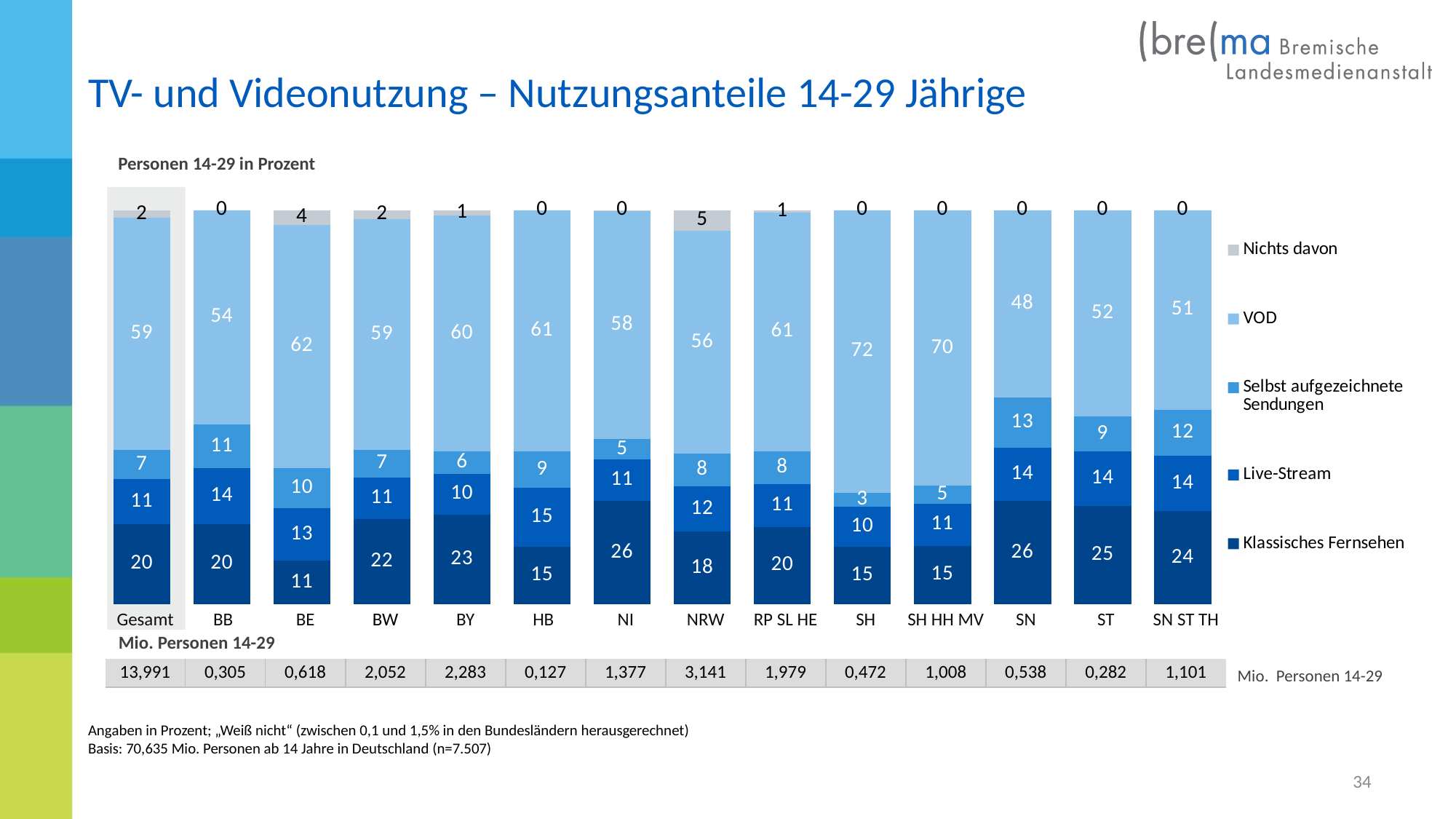
What kind of chart is shown on the slide? Stacked bar chart What is the difference between the VOD values for SH and SN? 24 Which category has the lowest VOD value? SN Which category has the highest VOD value? SH Which is larger, the Selbst aufgezeichnete Sendungen value for SN or for SH? SN How many series does the legend list? 5 What is the VOD value for SH? 72 What is the Nichts davon value for NRW? 5 Which category has the lowest Klassisches Fernsehen value? BE How many categories are shown on the x axis? 14 What is the Klassisches Fernsehen value for BE? 11 What is the Live-Stream value for HB? 15